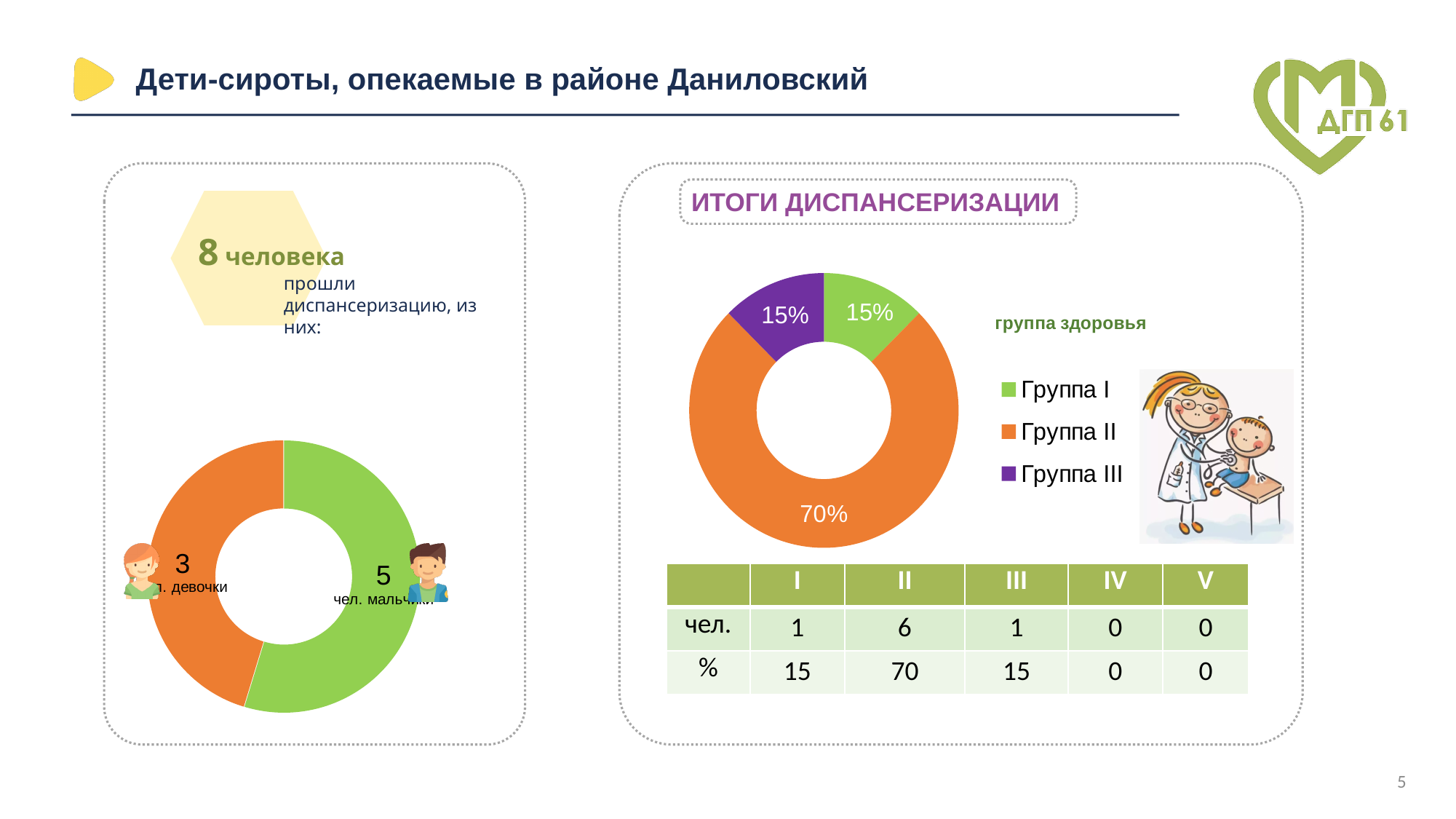
In the left chart, what is the difference between the number of boys and the number of girls? 2 How many entries does the legend of the right chart (группа здоровья) list? 3 In the right chart (группа здоровья), what share does Группа II have? 70% In the left chart, which group is larger, girls or boys? Boys (мальчики) In the right chart (группа здоровья), what is the difference between the share of Группа II and the share of Группа III? 55% In the right chart (группа здоровья), which group has the largest share? Группа II In the left chart, how many girls (девочки) are shown? 3 What type of chart is the left chart showing girls and boys? Donut chart In the right chart (группа здоровья), what colour represents Группа III? Purple In the right chart (группа здоровья), what share does Группа I have? 15% In the left chart, how many boys (мальчики) are shown? 5 In the left chart, what is the total number of children shown? 8